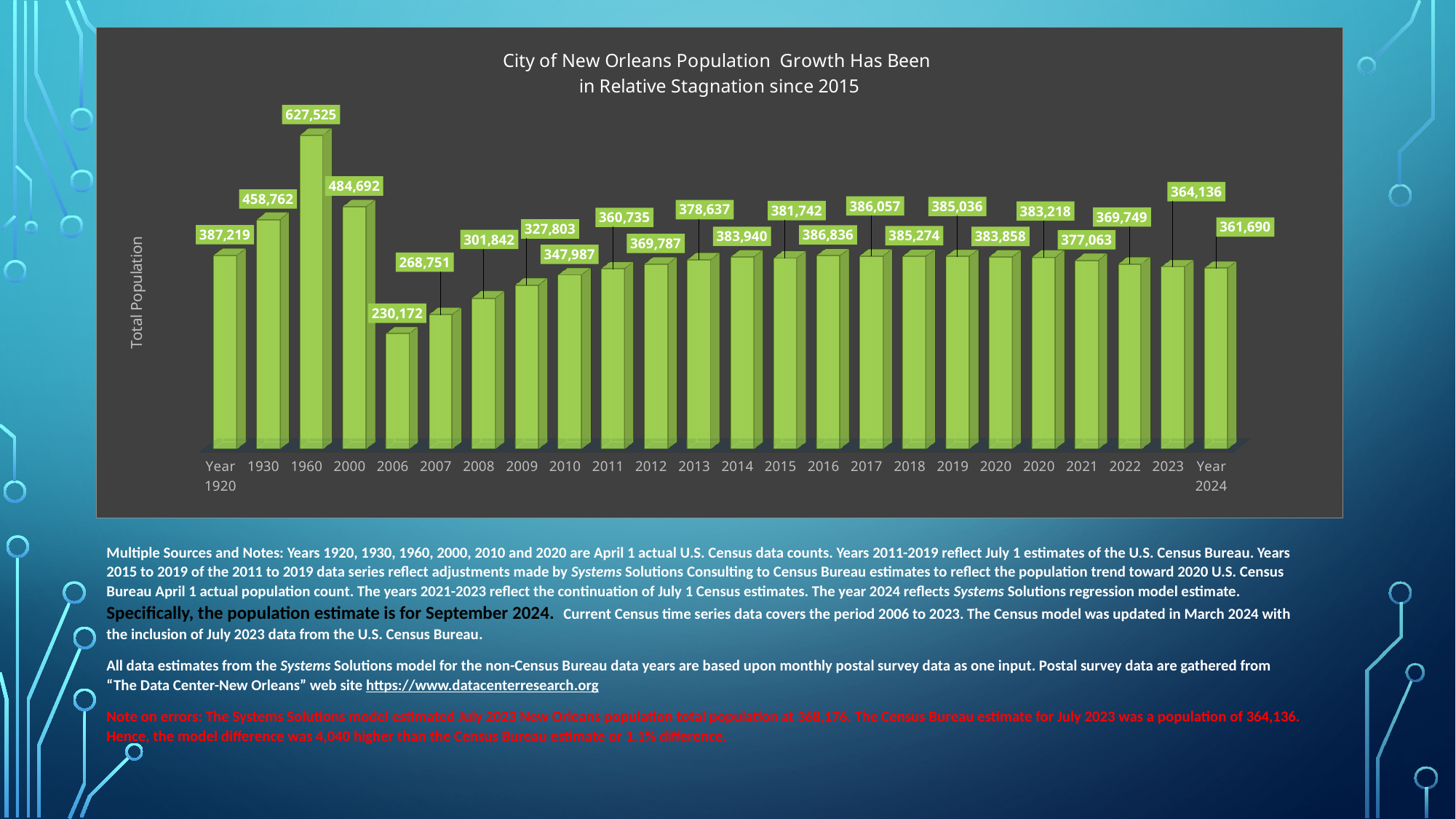
Which year had the larger population, 1930 or 2000? 2000 By how much did the population fall from 2023 to Year 2024? 2,446 What is the population value labelled for Year 2024? 361,690 What is the difference between the 1960 population and the 2000 population? 142,833 Do the population values rise or fall from 2006 through 2016? Rise What population value is shown for 2006? 230,172 Which year has the lowest population on the chart? 2006 How many bars are plotted on the chart? 24 Which year has the highest population on the chart? 1960 What type of chart is shown on the slide? Bar chart What was the population of New Orleans in 1960 according to the chart? 627,525 What population is shown for 2016? 386,836